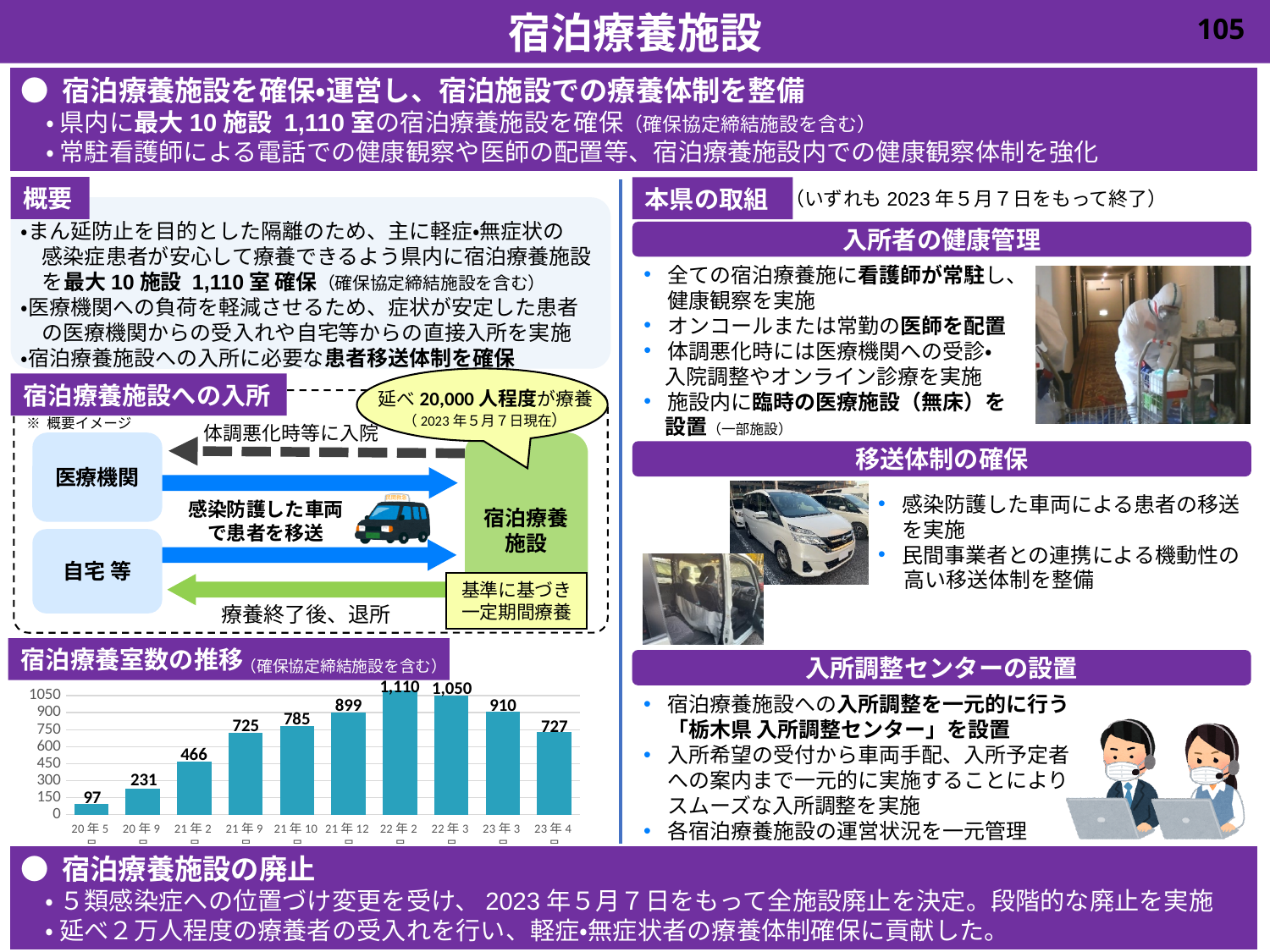
In the 宿泊療養室数の推移 chart, what is the difference between the values for 21年2月 and 20年9月? 235 In the 宿泊療養室数の推移 chart, which is larger, the value for 21年9月 or the value for 23年4月? 23年4月 In the 宿泊療養室数の推移 chart, what is the value for 20年5月? 97 In the 宿泊療養室数の推移 chart, which period has the lowest value? 20年5月 In the 宿泊療養室数の推移 chart, what is the value for 22年2月? 1,110 In the 宿泊療養室数の推移 chart, which period has the highest value? 22年2月 What type of chart is used in 宿泊療養室数の推移? bar chart In the 宿泊療養室数の推移 chart, what is the value for 23年4月? 727 In the 宿泊療養室数の推移 chart, is the value for 21年12月 greater or less than 750? greater How many periods are shown on the x axis of the 宿泊療養室数の推移 chart? 10 In the 宿泊療養室数の推移 chart, do the values rise or fall from 20年5月 to 22年2月? rise In the 宿泊療養室数の推移 chart, what is the difference between the values for 22年2月 and 22年3月? 60